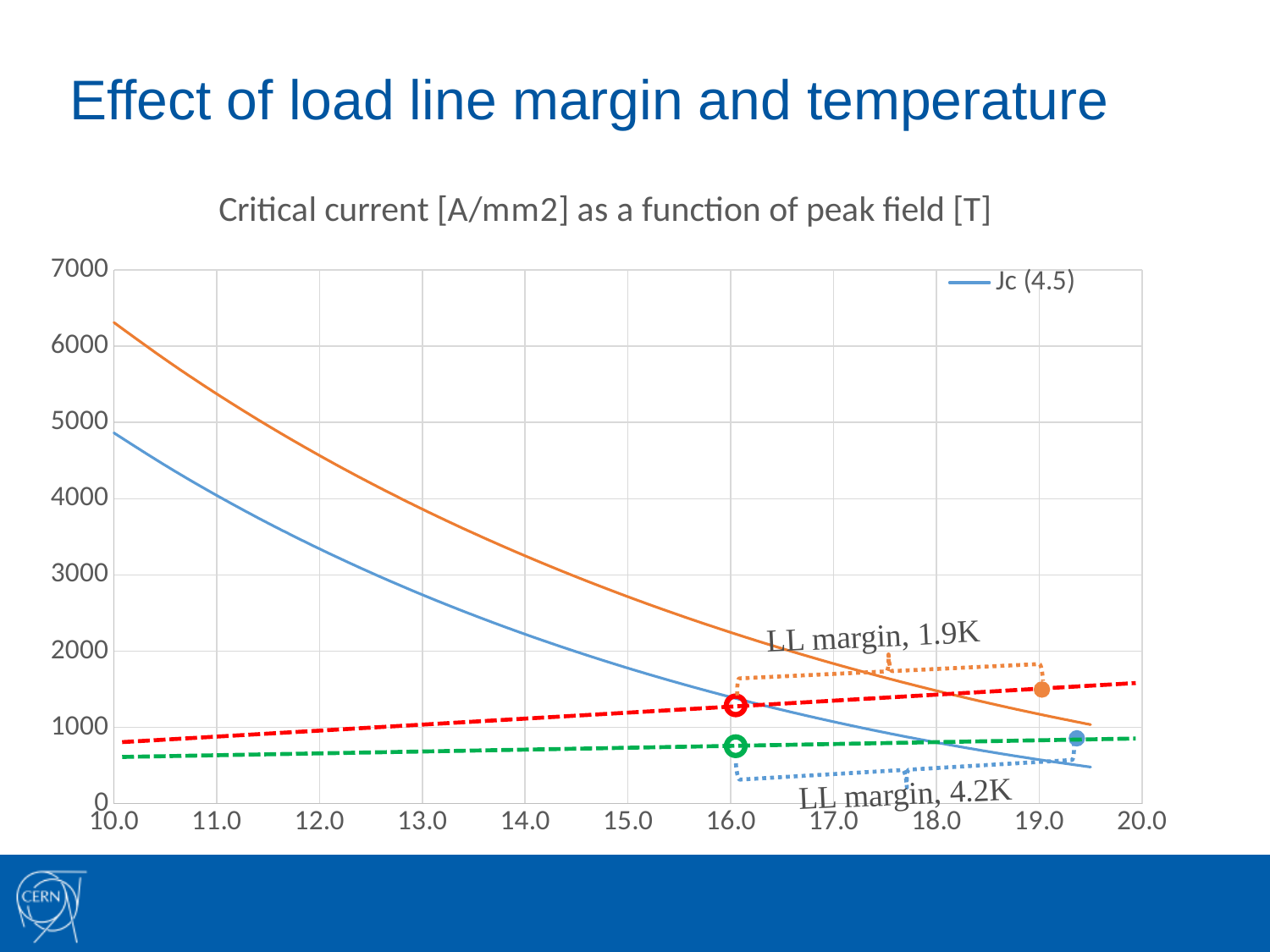
At a peak field of 12.0, is the value of the orange solid curve greater or less than 4000? greater At a peak field of 16.0, which is higher: the red dashed line or the green dashed line? red dashed line At a peak field of 10.0, is the value of the orange solid curve greater or less than 6000? greater How many series does the chart legend list? 1 What is the name of the series listed in the legend? Jc (4.5) At a peak field of 10.0, which is higher: the orange solid curve or the blue solid curve? orange solid curve Does the orange solid curve rise or fall as the peak field increases along the x axis? fall What is the title of the chart? Critical current [A/mm2] as a function of peak field [T] What kind of chart is shown on the slide? line chart At a peak field of 10.0, is the value of the blue solid curve greater or less than 4000? greater Does the red dashed line rise or fall as the peak field increases along the x axis? rise